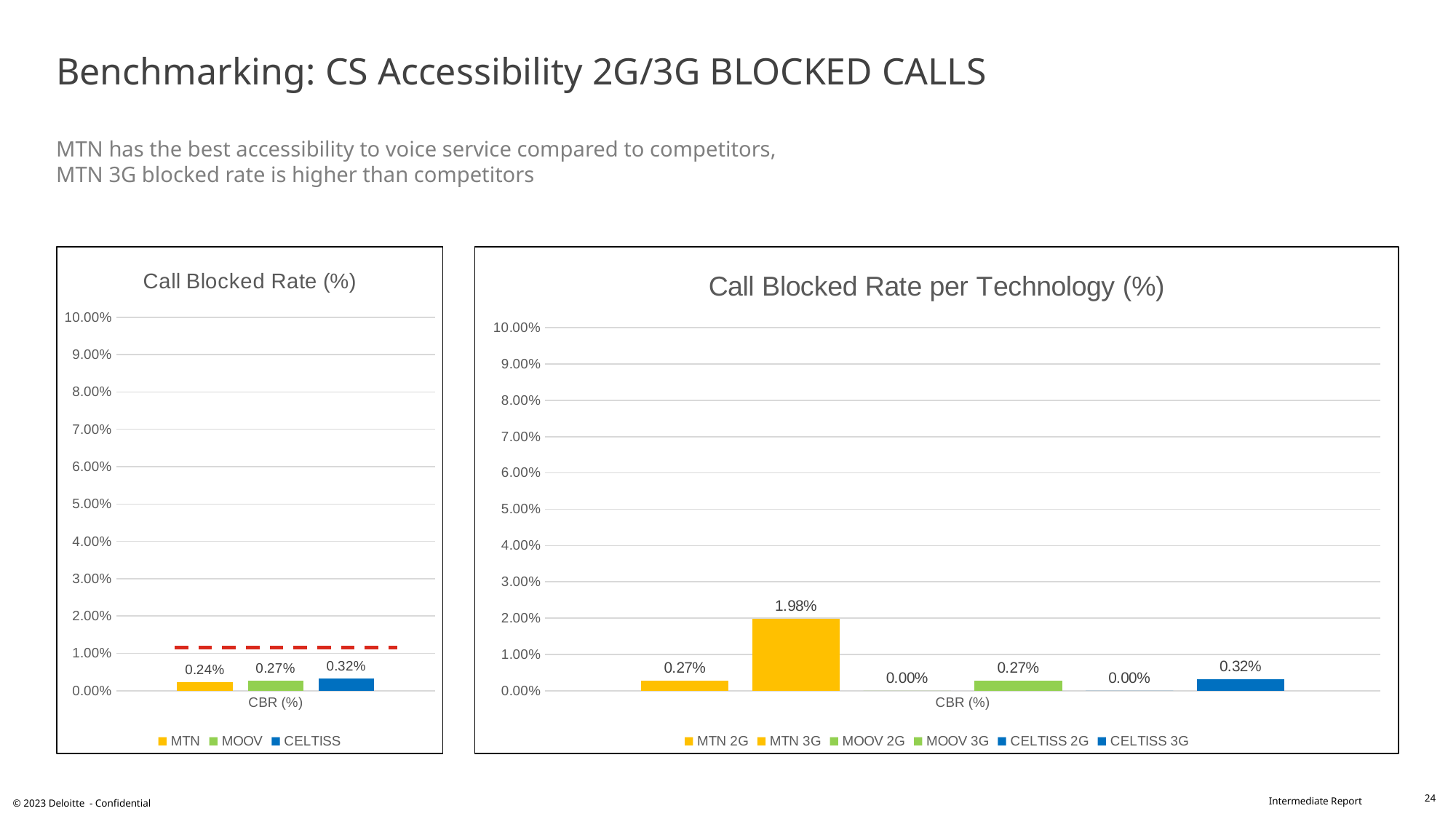
In the 'Call Blocked Rate per Technology (%)' chart, how many series does the legend list? 6 What type of chart is the 'Call Blocked Rate per Technology (%)' chart? Bar chart In the 'Call Blocked Rate (%)' chart, how many series does the legend list? 3 In the 'Call Blocked Rate per Technology (%)' chart, which is larger, MOOV 3G or CELTISS 3G? CELTISS 3G In the 'Call Blocked Rate per Technology (%)' chart, which series has the highest value? MTN 3G In the 'Call Blocked Rate per Technology (%)' chart, what is the difference between MTN 3G and MTN 2G? 1.71% In the 'Call Blocked Rate per Technology (%)' chart, what is the value for MTN 3G? 1.98% In the 'Call Blocked Rate (%)' chart, which operator has the lowest call blocked rate? MTN In the 'Call Blocked Rate per Technology (%)' chart, what is the value for CELTISS 3G? 0.32% In the 'Call Blocked Rate (%)' chart, which operator has the highest call blocked rate? CELTISS In the 'Call Blocked Rate (%)' chart, what is the value for MTN? 0.24% In the 'Call Blocked Rate (%)' chart, what is the difference between the CELTISS and MTN values? 0.08%